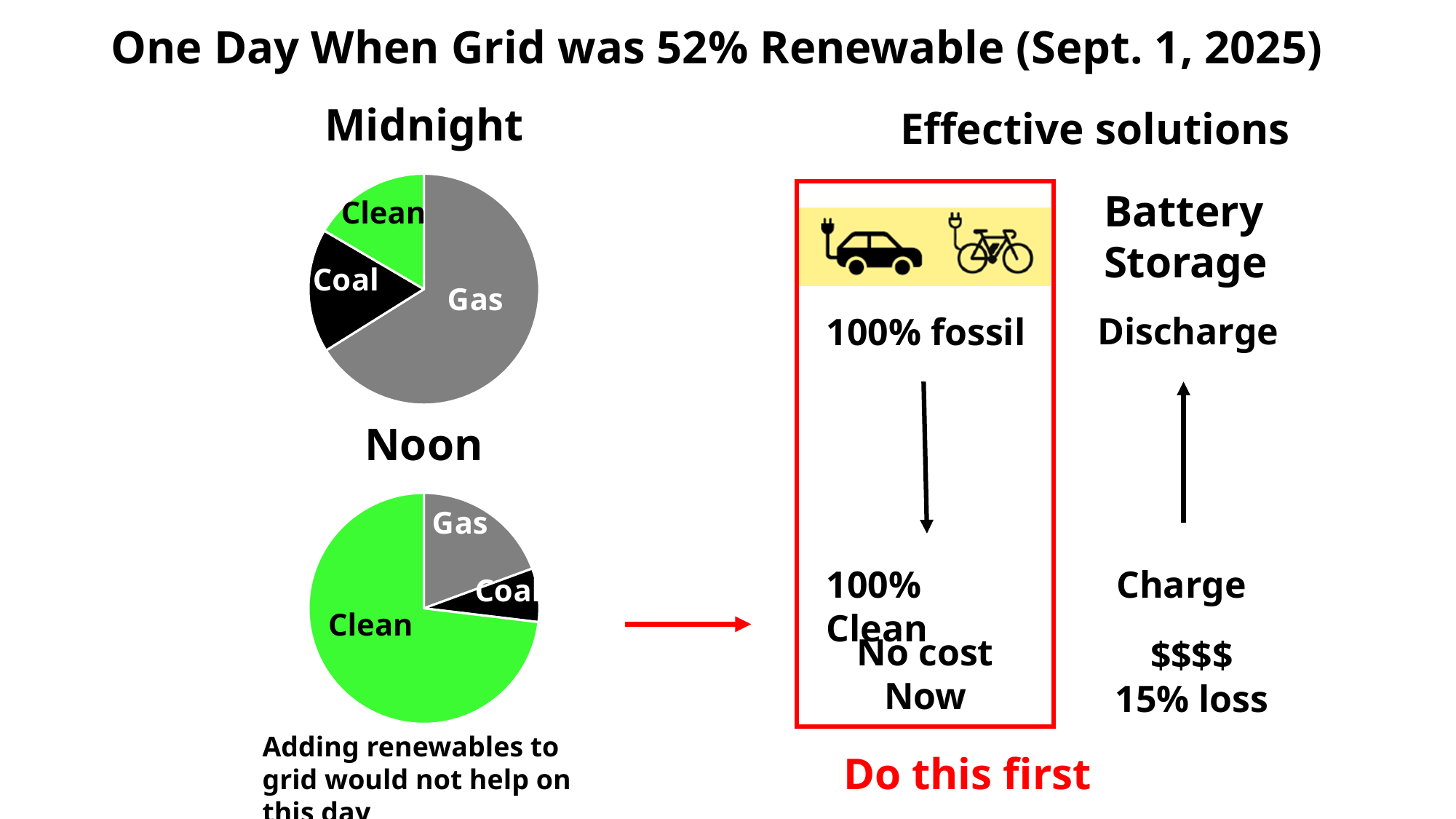
How many slices does the Midnight pie chart have? 3 How many categories are shown in the Noon pie chart? 3 In the Noon chart, which category has the largest slice? Clean In the Midnight chart, which slice is larger, Gas or Coal? Gas What kind of chart is the Midnight chart? pie chart In the Noon chart, which category has the smallest slice? Coal In the Noon chart, which slice is larger, Clean or Gas? Clean In the Midnight chart, which slice is larger, Gas or Clean? Gas In the Midnight chart, which category has the largest slice? Gas What is the title of the slide containing the two pie charts? One Day When Grid was 52% Renewable (Sept. 1, 2025) What colour is the Clean slice in the Noon pie chart? green